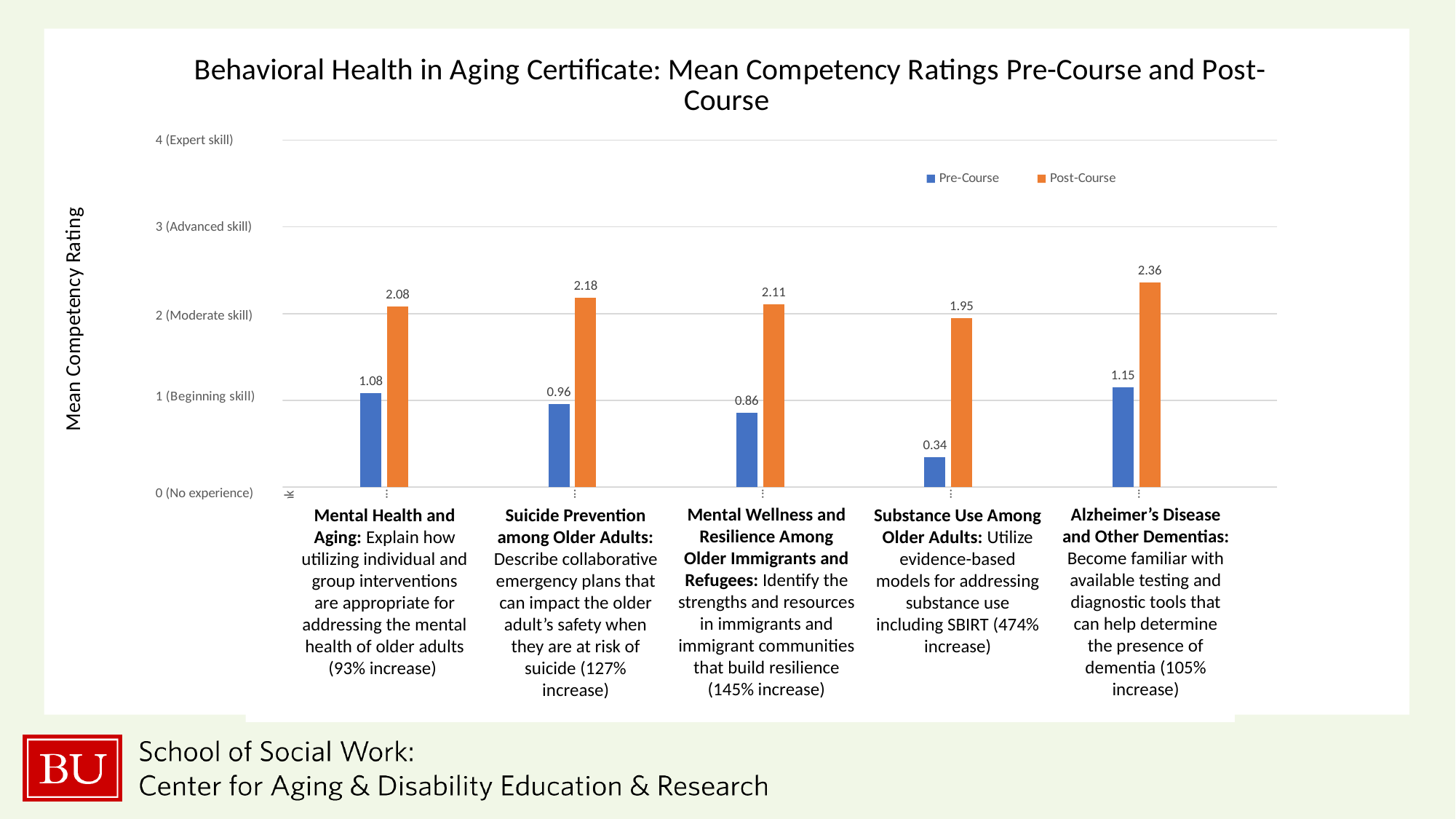
Which is larger: the Post-Course rating for Mental Wellness and Resilience Among Older Immigrants and Refugees or the Post-Course rating for Substance Use Among Older Adults? Mental Wellness and Resilience Among Older Immigrants and Refugees How many series does the legend list? 2 What is the Post-Course mean competency rating for Alzheimer's Disease and Other Dementias? 2.36 How many competency categories are shown on the x axis? 5 What kind of chart is shown on the slide? bar chart What is the Pre-Course mean competency rating for Mental Health and Aging? 1.08 What is the label of the y axis? Mean Competency Rating What is the difference between the Post-Course and Pre-Course ratings for Suicide Prevention among Older Adults? 1.22 Which category has the lowest Pre-Course rating? Substance Use Among Older Adults Which category has the highest Post-Course rating? Alzheimer's Disease and Other Dementias Is the Post-Course rating for Substance Use Among Older Adults greater or less than 2? less What is the Pre-Course rating for Substance Use Among Older Adults? 0.34